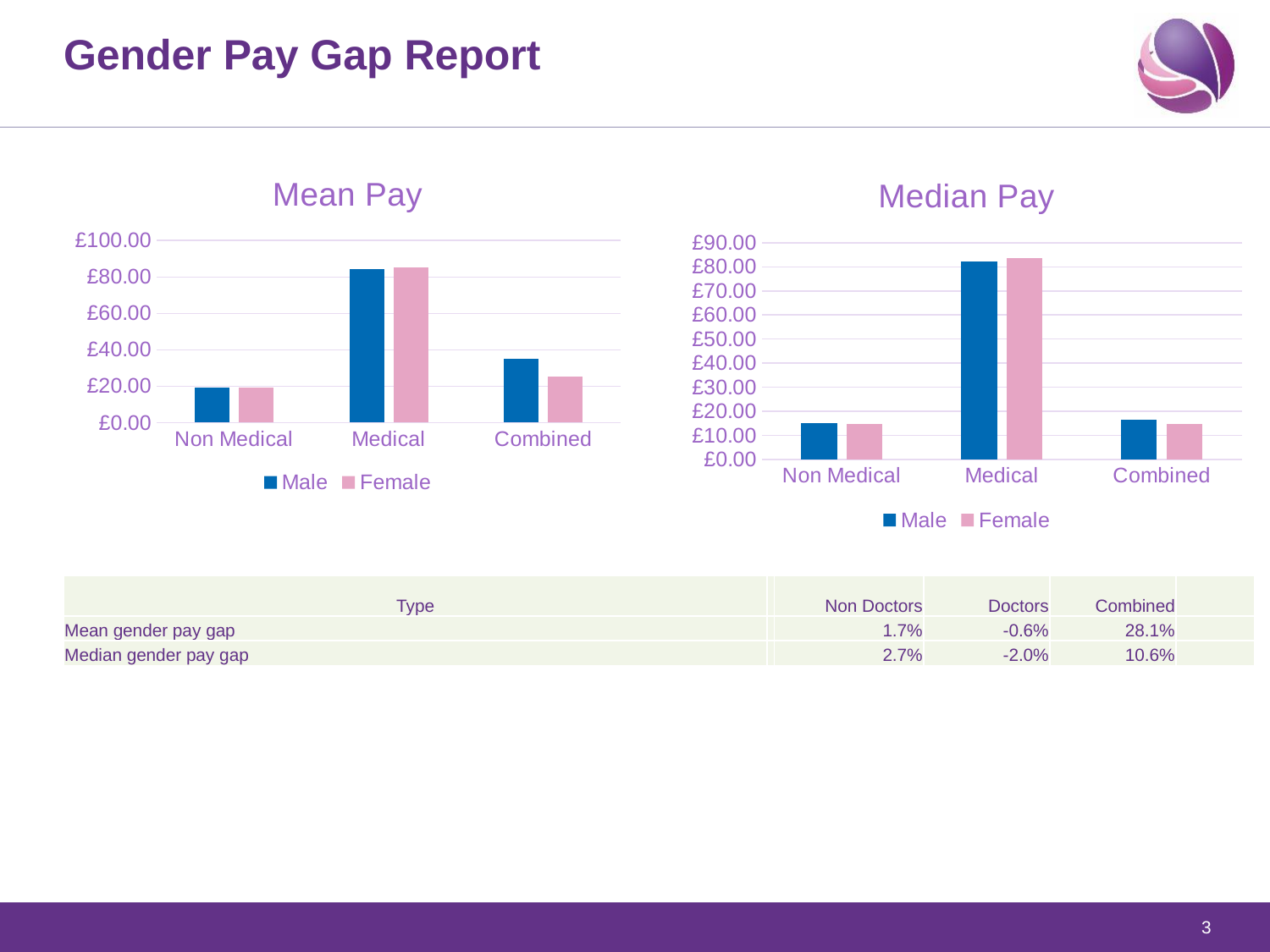
In the Median Pay chart, what colour are the Female bars? pink In the Mean Pay chart, is the Female value for Medical greater or less than £60.00? greater What kind of chart is the Mean Pay chart? bar chart In the Median Pay chart, which category has the highest Female bar? Medical In the Mean Pay chart, which category has the highest Male bar? Medical What is the title of the chart on the right of the slide? Median Pay How many series does the legend of the Mean Pay chart list? 2 In the Median Pay chart, is the Female value for Combined greater or less than £20.00? less In the Mean Pay chart, which is larger for Combined: the Male value or the Female value? Male In the Mean Pay chart, is the Male value for Combined greater or less than £20.00? greater How many categories are shown on the x axis of the Median Pay chart? 3